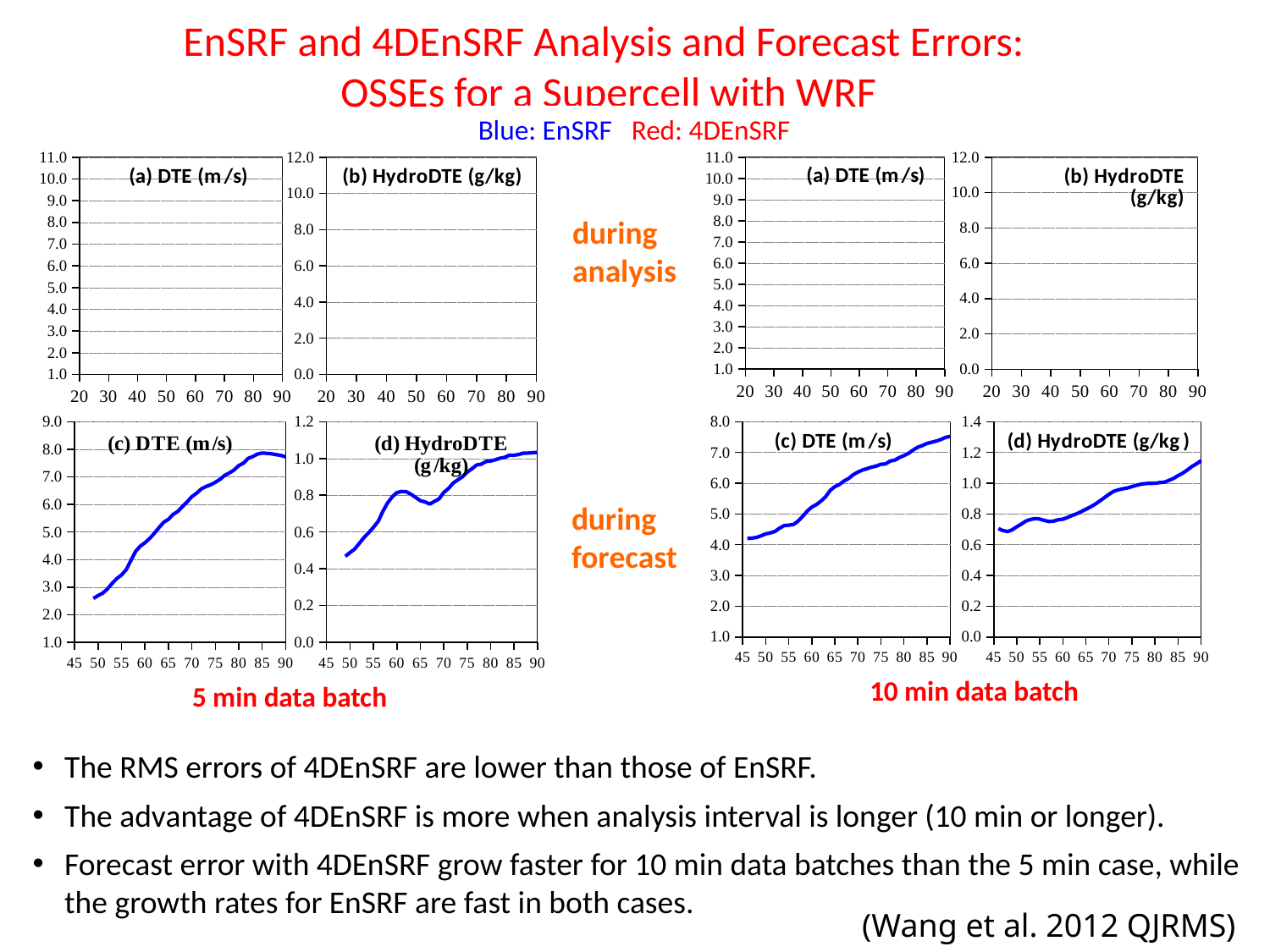
In panel (d) HydroDTE (g/kg) for the 10 min data batch, is the value at x = 90 greater or less than 1.0? greater In panel (d) HydroDTE (g/kg) for the 5 min data batch, is the value at x = 50 greater or less than 0.6? less In panel (c) DTE (m/s) for the 10 min data batch, is the value at x = 45 greater or less than 3.0? greater In panel (d) HydroDTE (g/kg) for the 10 min data batch, does the plotted line generally rise or fall from x = 45 to x = 90? rise What is the highest y-axis tick shown on panel (c) DTE (m/s) for the 5 min data batch? 9.0 According to the slide's colour key, which method is plotted in blue? EnSRF What kind of chart is panel (c) DTE (m/s) under the 5 min data batch? line chart How many chart panels are shown on the slide in total? 8 In panel (c) DTE (m/s) for the 5 min data batch, does the plotted line rise or fall as the x axis increases from 50 to 90? rise